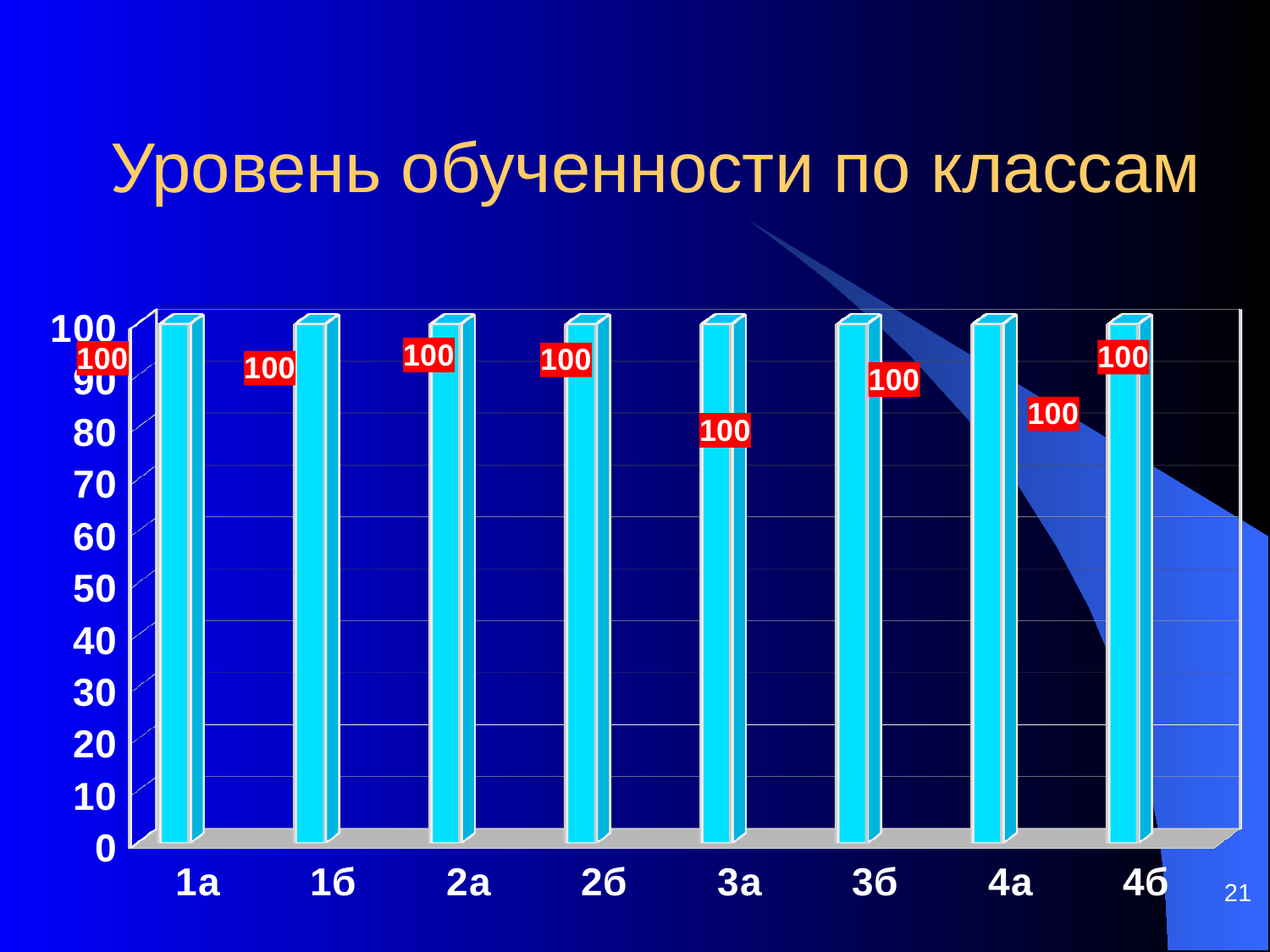
How many classes are shown on the x axis? 8 What is the title of the chart? Уровень обученности по классам Do the values rise, fall, or stay the same from class 1а to class 4б? stay the same What is the value for class 1а? 100 Is the value for class 3а greater or less than 50? greater What kind of chart is shown on the slide? bar chart What is the difference between the values for class 1б and class 4а? 0 What is the value for class 4б? 100 What is the value for class 3б? 100 What is the value for class 2а? 100 Is the value for class 2б larger than, smaller than, or equal to the value for class 3б? equal What is the highest value shown on the vertical axis? 100